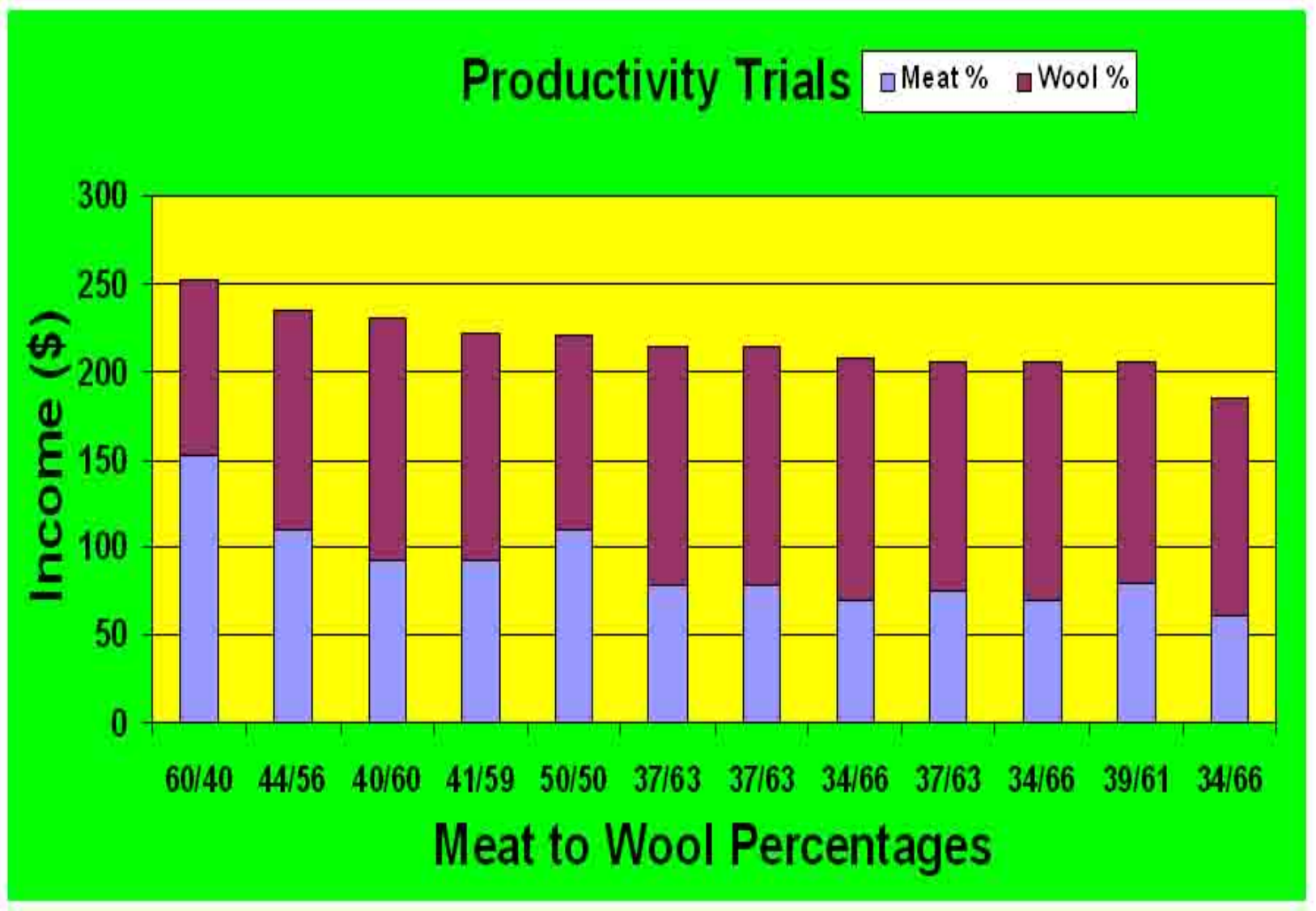
What kind of chart is shown on the slide? stacked bar chart Is the total income for the rightmost 34/66 bar greater or less than 200? less Do the total incomes generally rise or fall from left to right along the x axis? fall Which bar has the lowest total income? the last bar (34/66, rightmost) How many series does the legend list? 2 Which category has the highest total income? 60/40 How many bars are plotted along the x axis? 12 Is the total income for the 60/40 bar greater or less than 200? greater Which has the larger Meat % portion, the 60/40 bar or the 44/56 bar? 60/40 Is the Meat % portion of the 60/40 bar greater or less than 100? greater What is the title of the chart? Productivity Trials